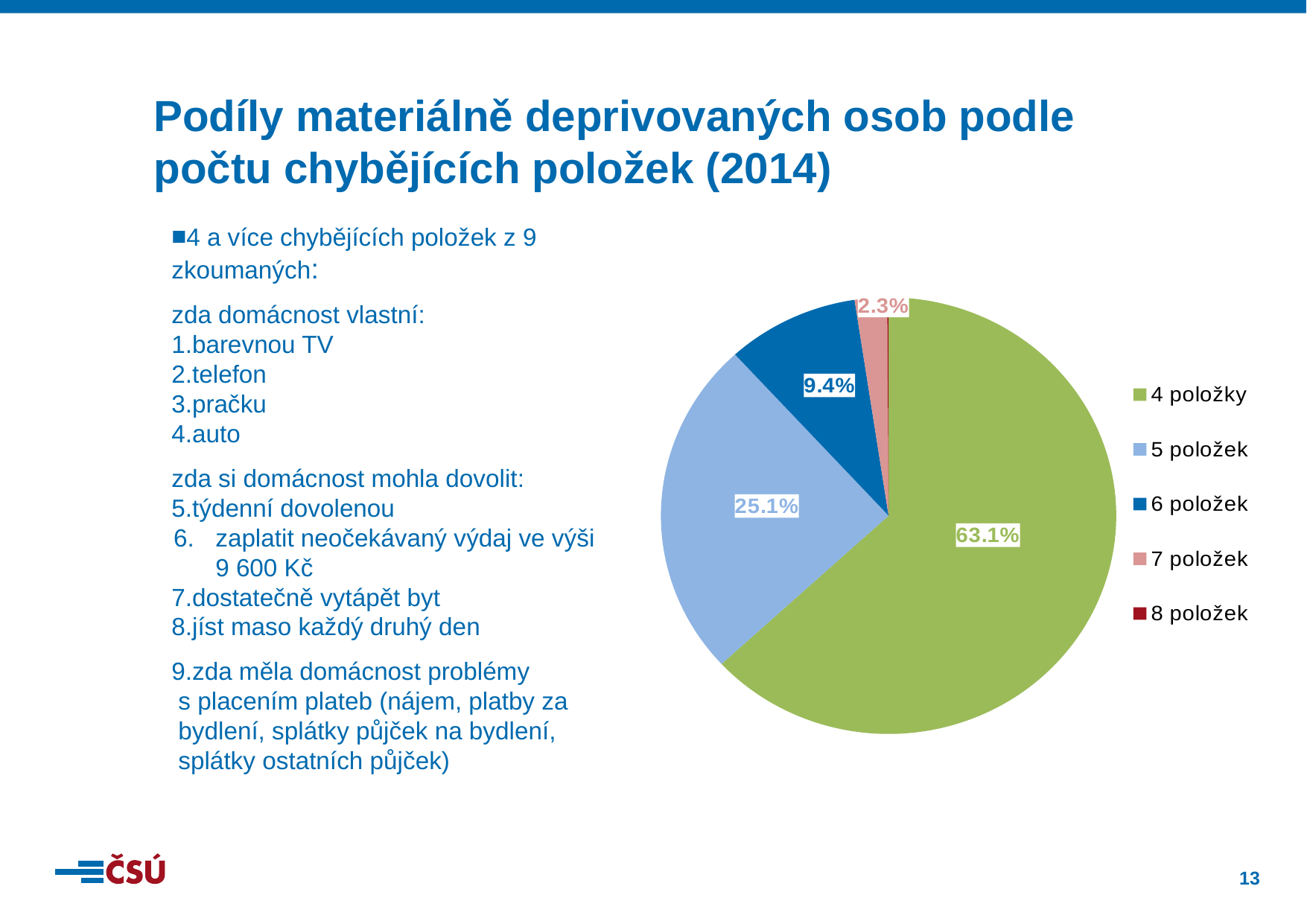
Which category has the largest slice of the pie? 4 položky What is the value shown for "7 položek"? 2.3% What is the value shown for "5 položek"? 25.1% What is the value shown for "6 položek"? 9.4% What is the combined share of "5 položek" and "6 položek"? 34.5% What share of the pie does the "4 položky" slice represent? 63.1% What colour is the "4 položky" slice? Green Which is larger, the share for "6 položek" or the share for "7 položek"? 6 položek Which category has the smallest slice of the pie? 8 položek How many categories does the legend list? 5 What is the difference between the shares for "4 položky" and "5 položek"? 38.0 percentage points What kind of chart is shown on the slide? Pie chart